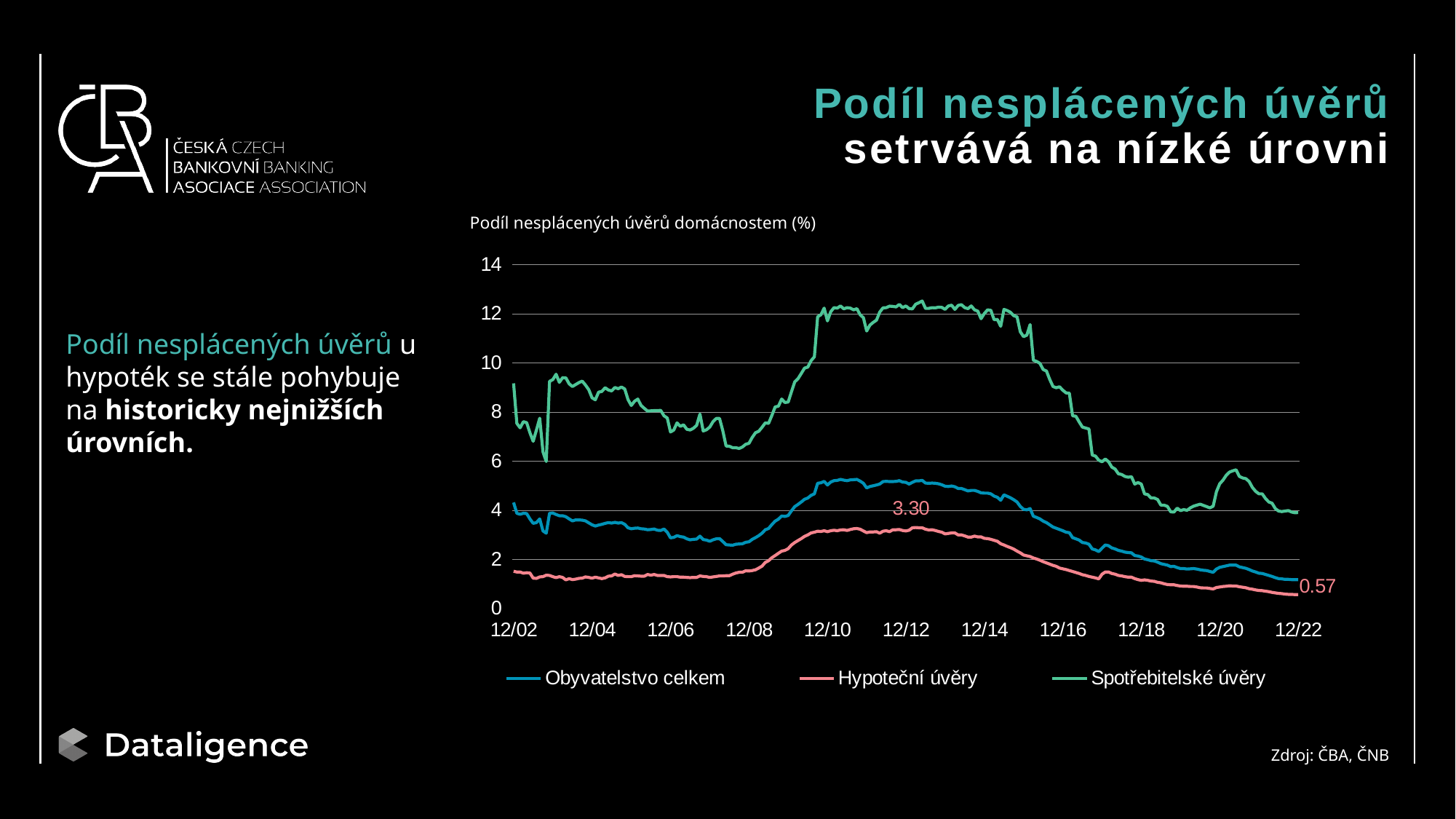
How many series does the legend list? 3 Is the value of Spotřebitelské úvěry at 12/12 greater or less than 10? greater Is the value of Obyvatelstvo celkem at 12/22 greater or less than 2? less What is the value labelled at the end of the Hypoteční úvěry line (12/22)? 0.57 Which series has the lowest values across the whole period? Hypoteční úvěry What is the difference between the labelled peak (3.30) and the labelled end value (0.57) of the Hypoteční úvěry line? 2.73 Which series has the highest value at 12/12? Spotřebitelské úvěry Does the Spotřebitelské úvěry line rise or fall between 12/16 and 12/18? fall Is the value of Spotřebitelské úvěry at 12/22 greater or less than 6? less What is the title of the chart? Podíl nesplácených úvěrů domácnostem (%) What kind of chart is shown on the slide? line chart What is the peak value labelled on the Hypoteční úvěry line? 3.30